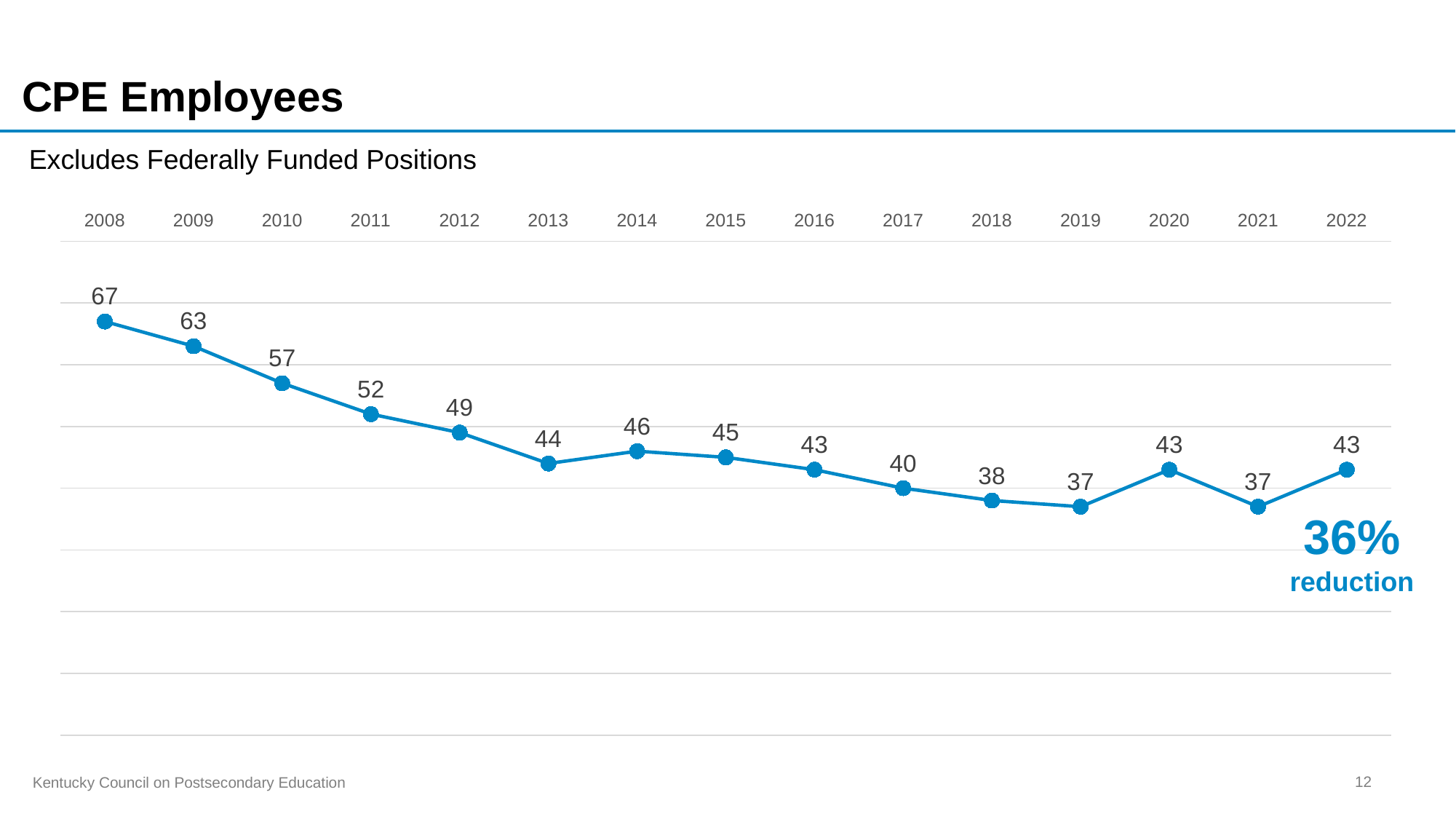
What was the number of CPE employees in 2022? 43 What is the difference between the values for 2010 and 2011? 5 What is the lowest value plotted on the chart? 37 How many years are plotted on the chart? 15 What was the number of CPE employees in 2008? 67 Which year had the highest number of CPE employees? 2008 What percentage reduction is highlighted on the chart? 36% What is the difference between the number of employees in 2008 and in 2022? 24 What was the number of CPE employees in 2013? 44 What kind of chart is shown on the slide? Line chart Which year had more employees, 2014 or 2017? 2014 Do the values generally rise or fall from 2008 to 2022? Fall